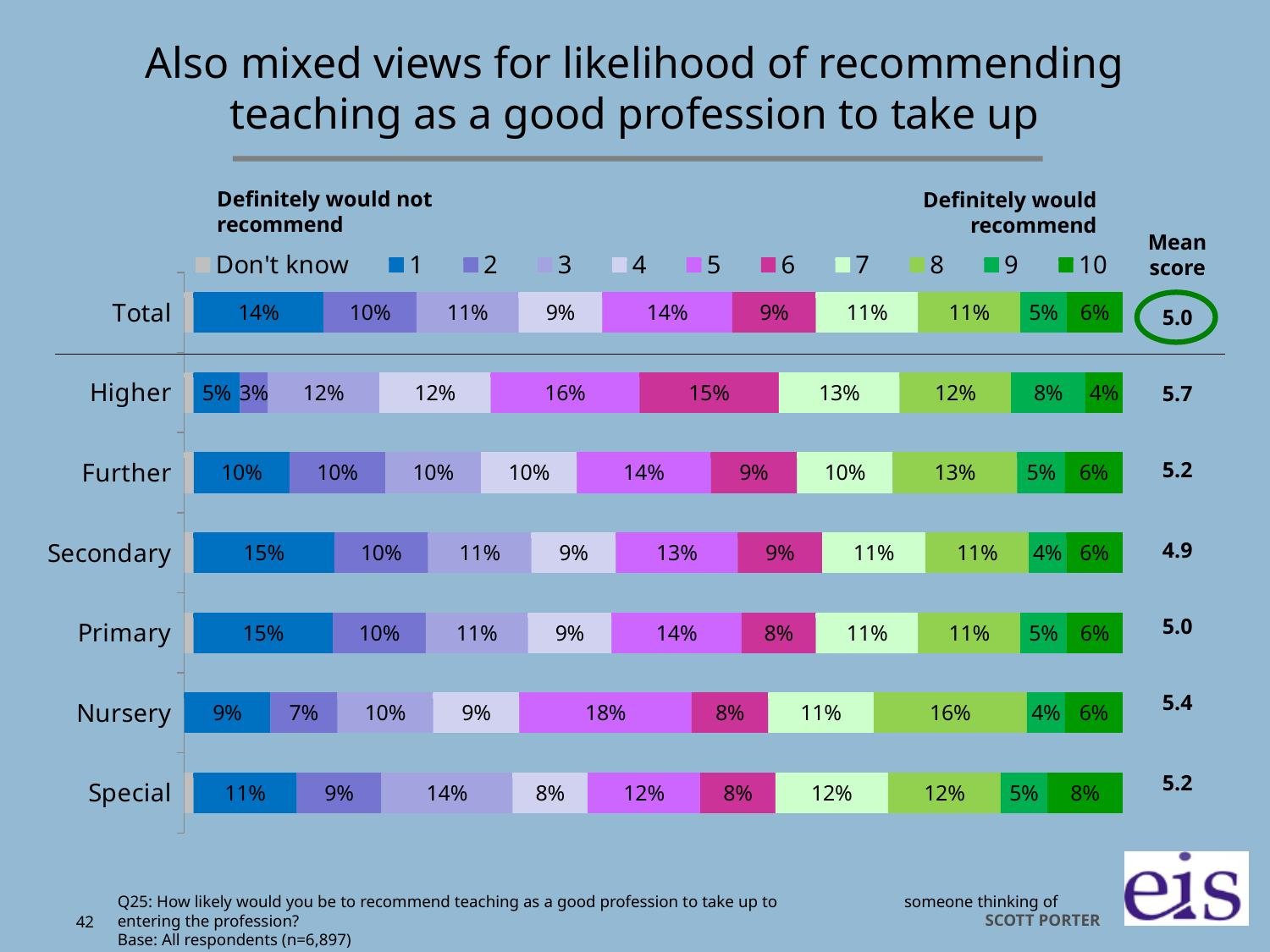
Which category has the lowest mean score? Secondary How many series does the legend list? 11 What percentage of Nursery respondents gave a rating of 5? 18% How many percentage points higher is the rating-5 share for Nursery than for Total? 4 percentage points Which category has the highest mean score? Higher Which has a larger share of respondents giving a rating of 1: Higher or Secondary? Secondary What percentage of Total respondents gave a rating of 1? 14% What kind of chart is shown on the slide? Stacked bar chart What percentage of Higher respondents gave a rating of 6? 15% What is the mean score for the Higher category? 5.7 How many categories (bars) are shown in the chart? 7 What percentage of Special respondents gave a rating of 10? 8%